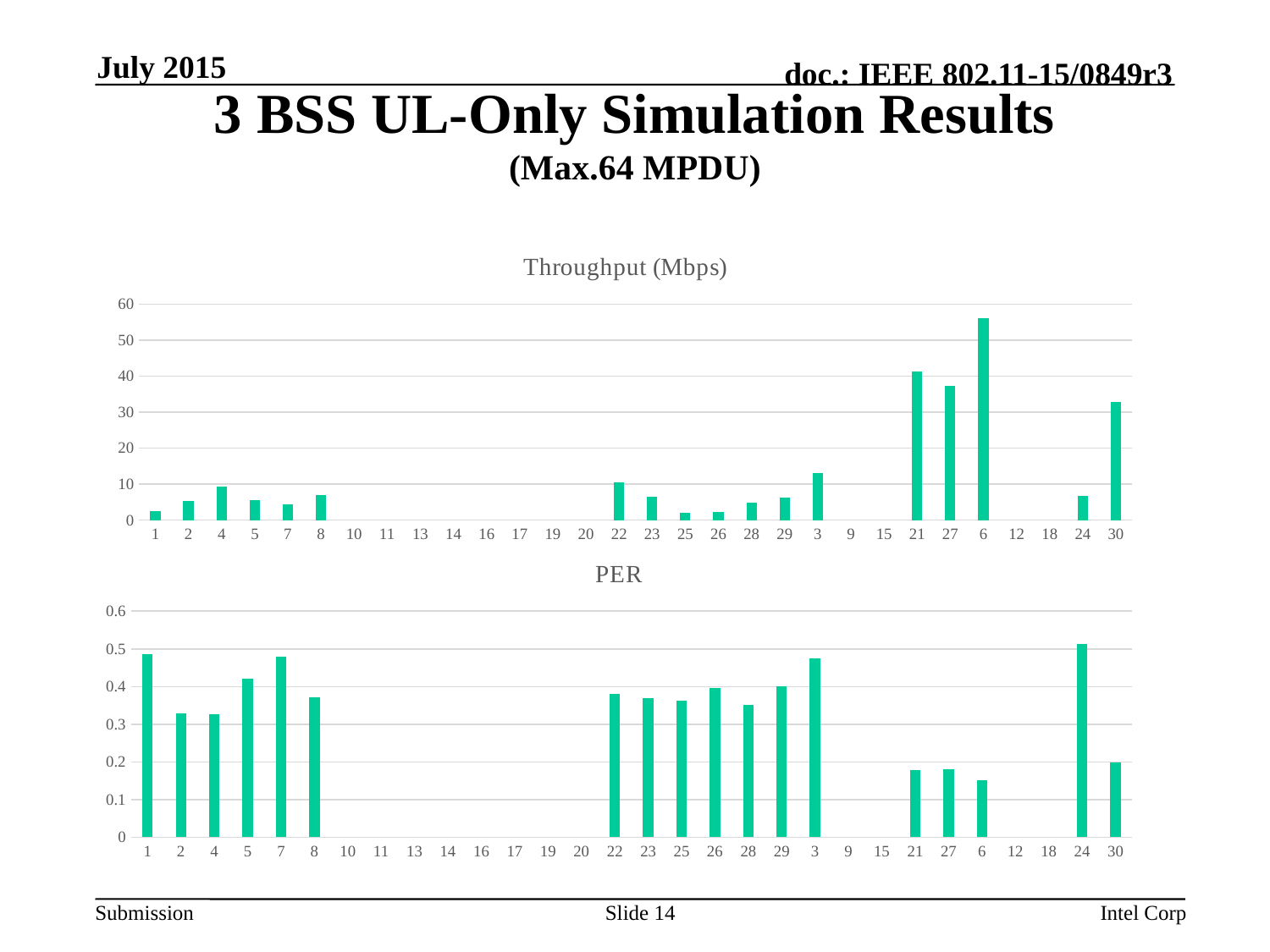
What kind of chart is the Throughput (Mbps) chart? bar chart In the PER chart, is the value for category 6 greater or less than 0.2? less In the Throughput (Mbps) chart, is the value for category 6 greater or less than 50? greater In the PER chart, which is larger, the value for category 7 or the value for category 21? 7 In the Throughput (Mbps) chart, is the value for category 21 greater or less than 40? greater In the Throughput (Mbps) chart, which is larger, the value for category 4 or the value for category 2? 4 How many categories are shown on the x axis of the PER chart? 30 What is the title of the top chart on the slide? Throughput (Mbps) In the Throughput (Mbps) chart, which is larger, the value for category 6 or the value for category 21? 6 In the Throughput (Mbps) chart, which category has the highest value? 6